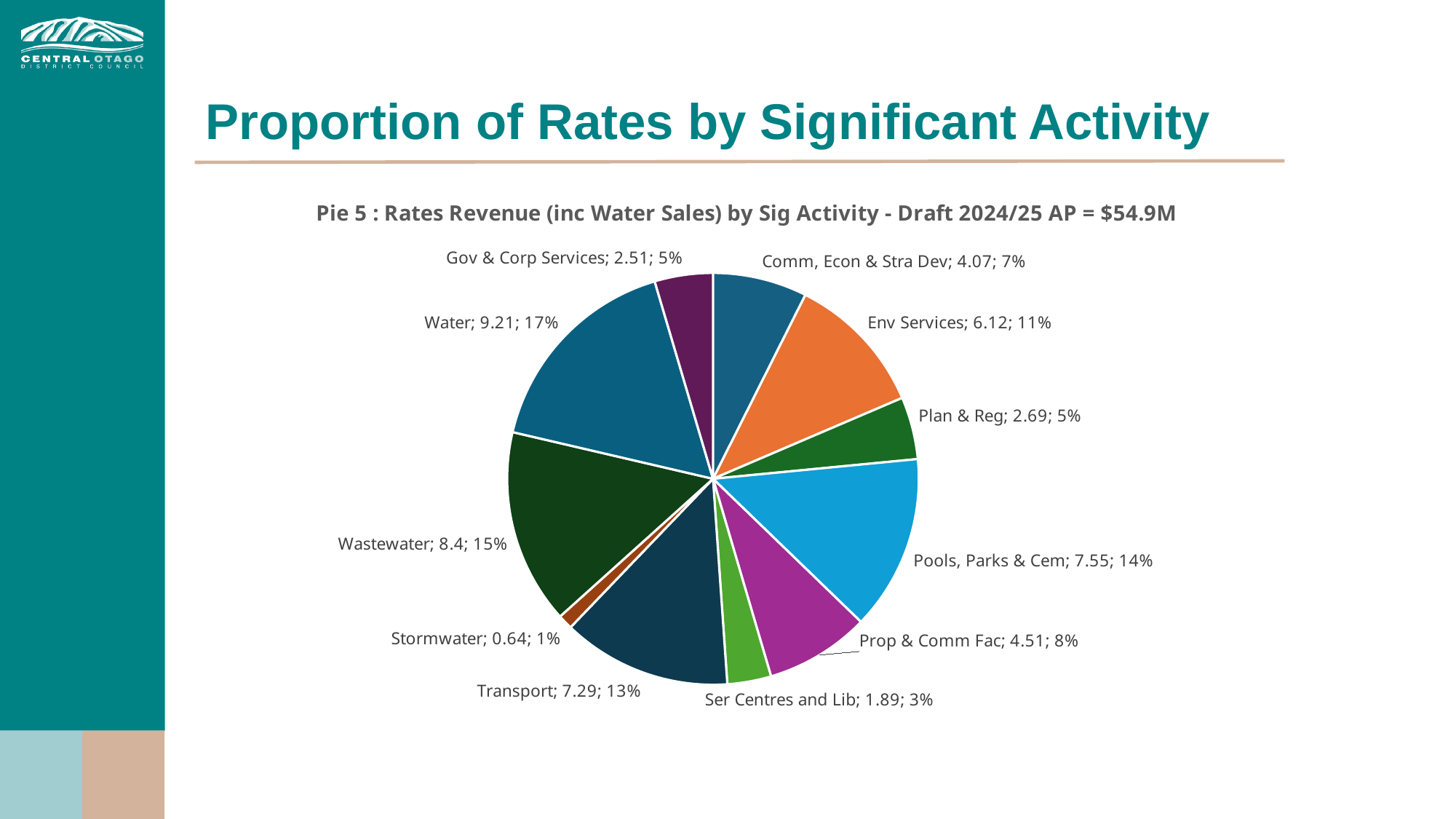
What is the value shown for Ser Centres and Lib? 1.89 Which activity has the smallest slice of the pie? Stormwater What is the difference between the values for Water and Wastewater? 0.81 What is the value shown for Water? 9.21 What type of chart is shown on the slide? Pie chart Which has a larger value, Transport or Pools, Parks & Cem? Pools, Parks & Cem Which activity has the largest slice of the pie? Water What percentage share is shown for Stormwater? 1% What total rates revenue is stated in the chart title? $54.9M What percentage share is shown for Pools, Parks & Cem? 14% How many activities (slices) are shown in the pie chart? 11 What is the value shown for Env Services? 6.12